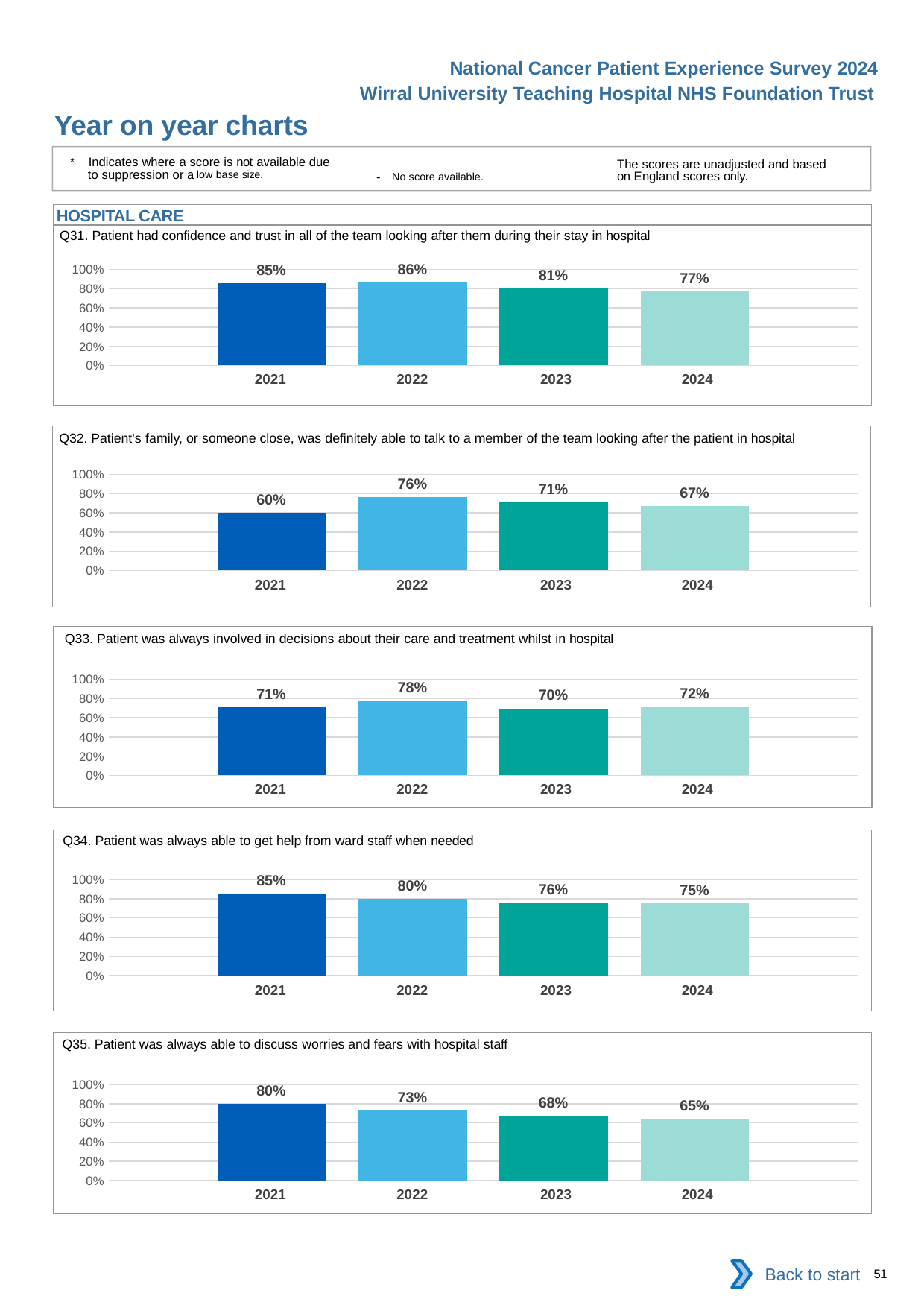
In the Q34 chart (patient was always able to get help from ward staff), what is the value for 2023? 76% In the Q31 chart (patient had confidence and trust in all of the team), which year has the lowest value? 2024 In the Q35 chart (patient was always able to discuss worries and fears), what is the value for 2024? 65% In the Q31 chart (patient had confidence and trust in all of the team), what is the value for 2022? 86% In the Q34 chart (patient was always able to get help from ward staff), do the values rise or fall from 2021 to 2024? fall In the Q33 chart (patient was always involved in decisions about their care), which is larger, the value for 2021 or 2024? 2024 What kind of chart is used for Q31? bar chart In the Q32 chart (patient's family was definitely able to talk to a member of the team), what is the difference between the 2022 and 2024 values? 9 percentage points In the Q32 chart (patient's family was definitely able to talk to a member of the team), what is the value for 2021? 60% In the Q33 chart (patient was always involved in decisions about their care), which year has the highest value? 2022 In the Q35 chart (patient was always able to discuss worries and fears), what is the difference between the 2021 and 2023 values? 12 percentage points How many years are shown on the x axis of the Q35 chart? 4